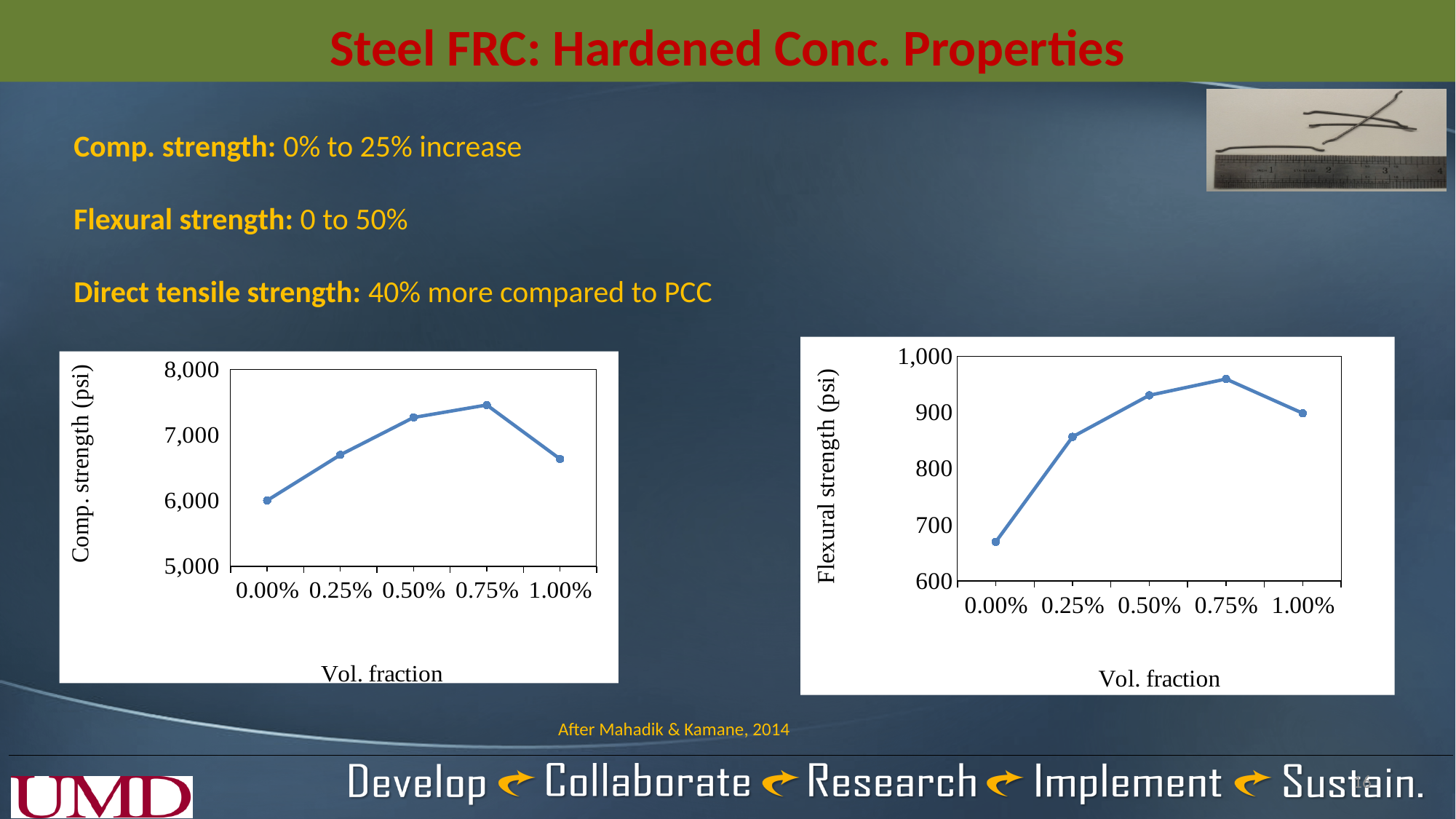
In the right chart (Flexural strength), is the value at 0.25% greater or less than 800? greater In the left chart (Comp. strength), how many data points are plotted? 5 In the right chart (Flexural strength), at which volume fraction is the flexural strength lowest? 0.00% In the left chart (Comp. strength), at which volume fraction is the compressive strength highest? 0.75% What kind of chart is the right chart (Flexural strength vs Vol. fraction)? line chart In the left chart (Comp. strength), is the value at 0.50% greater or less than 7,000? greater What kind of chart is the left chart (Comp. strength vs Vol. fraction)? line chart In the left chart (Comp. strength), at which volume fraction is the compressive strength lowest? 0.00% In the left chart (Comp. strength), is the value at 0.75% larger or smaller than the value at 1.00%? larger In the right chart (Flexural strength), how many volume fraction categories are shown on the x axis? 5 In the right chart (Flexural strength), at which volume fraction is the flexural strength highest? 0.75% In the right chart (Flexural strength), is the value at 0.00% greater or less than 700? less